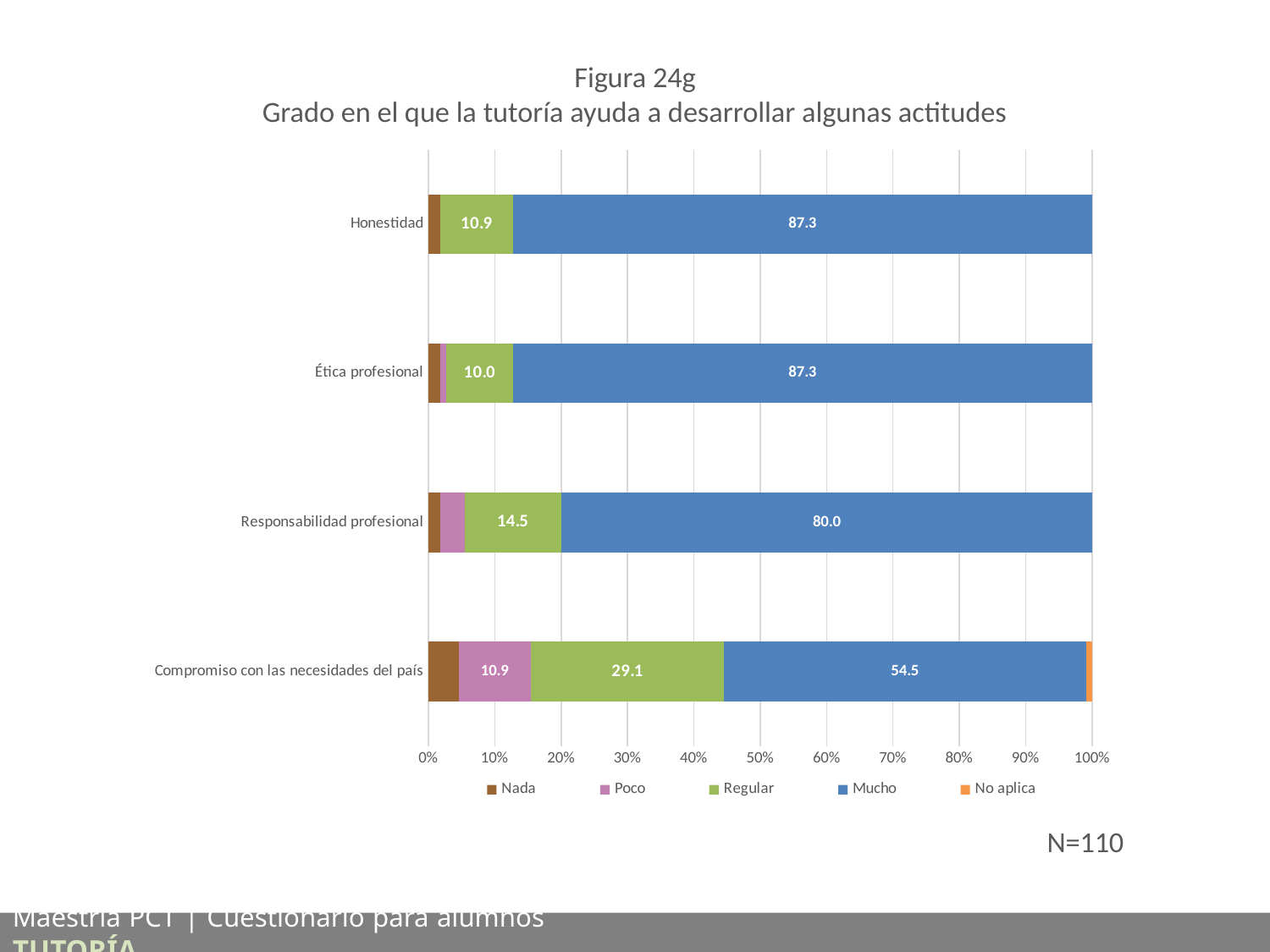
Is the 'Regular' value for Responsabilidad profesional larger than the 'Regular' value for Honestidad? Yes How many series does the legend list? 5 What is the value of 'Regular' for Ética profesional? 10.0 How many categories are shown on the chart? 4 What is the value of 'Mucho' for Honestidad? 87.3 What is the difference between the 'Mucho' values for Honestidad and Responsabilidad profesional? 7.3 Which category has the lowest 'Mucho' value? Compromiso con las necesidades del país What is the value of 'Poco' for Compromiso con las necesidades del país? 10.9 What is the value of 'Mucho' for Responsabilidad profesional? 80.0 Which category has the highest 'Regular' value? Compromiso con las necesidades del país What type of chart is shown on the slide? Stacked bar chart What is the value of 'Regular' for Compromiso con las necesidades del país? 29.1